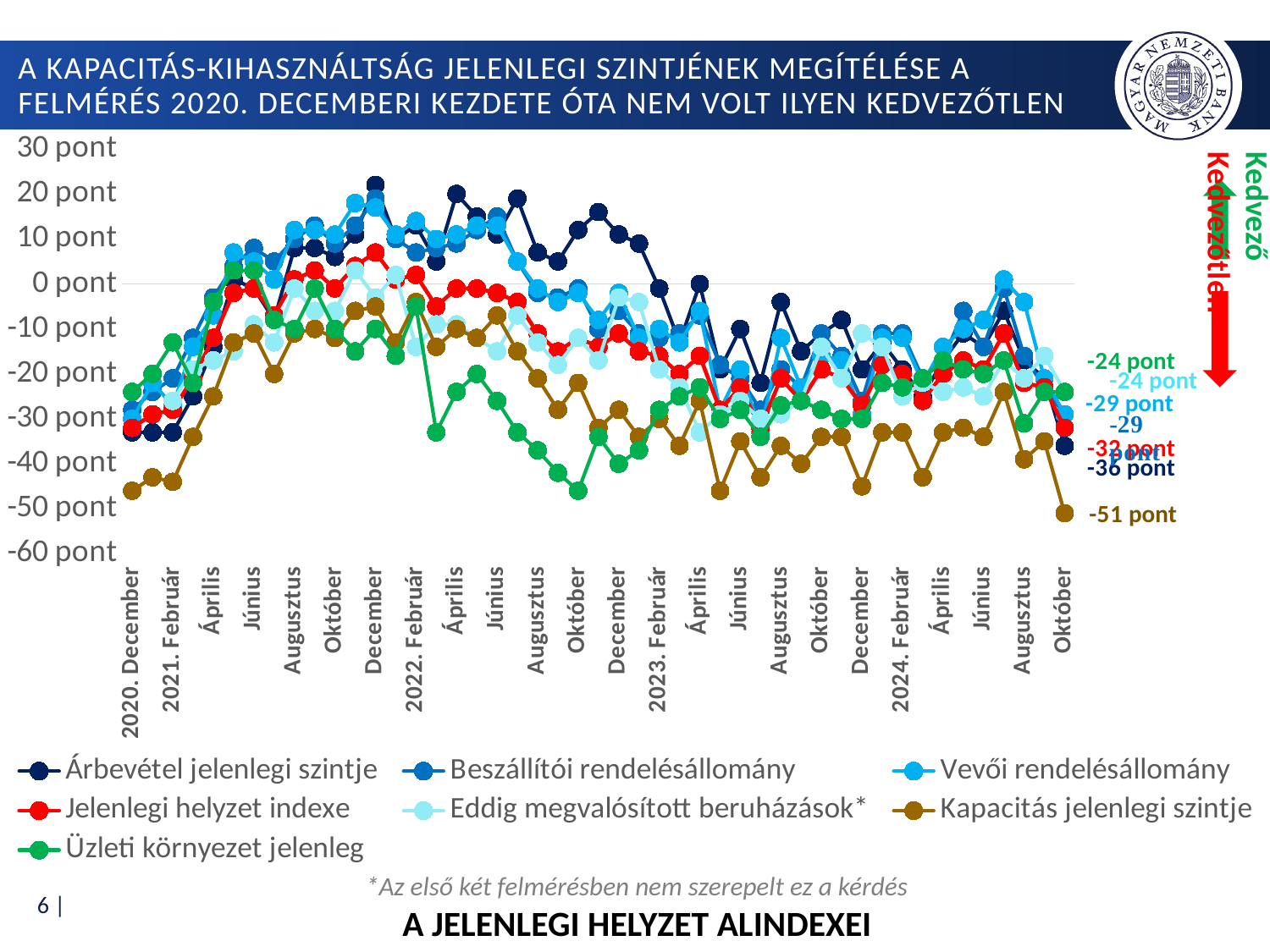
What is the difference between the latest values of 'Árbevétel jelenlegi szintje' (-36 pont) and 'Kapacitás jelenlegi szintje' (-51 pont)? 15 pont What kind of chart is shown on the slide? line chart Does the 'Kapacitás jelenlegi szintje' series rise or fall between 2020. December and 2021. Június? rise What is the latest labelled value for the series 'Kapacitás jelenlegi szintje'? -51 pont What is the latest labelled value for the series 'Árbevétel jelenlegi szintje'? -36 pont Is the value of 'Kapacitás jelenlegi szintje' in 2020. December greater or less than -40 pont? less What is the highest value shown on the vertical axis? 30 pont At the last data point, which is larger: 'Árbevétel jelenlegi szintje' or 'Kapacitás jelenlegi szintje'? Árbevétel jelenlegi szintje What is the latest labelled value for the series 'Jelenlegi helyzet indexe'? -32 pont What is the title printed below the chart? A JELENLEGI HELYZET ALINDEXEI Which series has the lowest value at the last data point (Október 2024)? Kapacitás jelenlegi szintje How many series does the legend list? 7